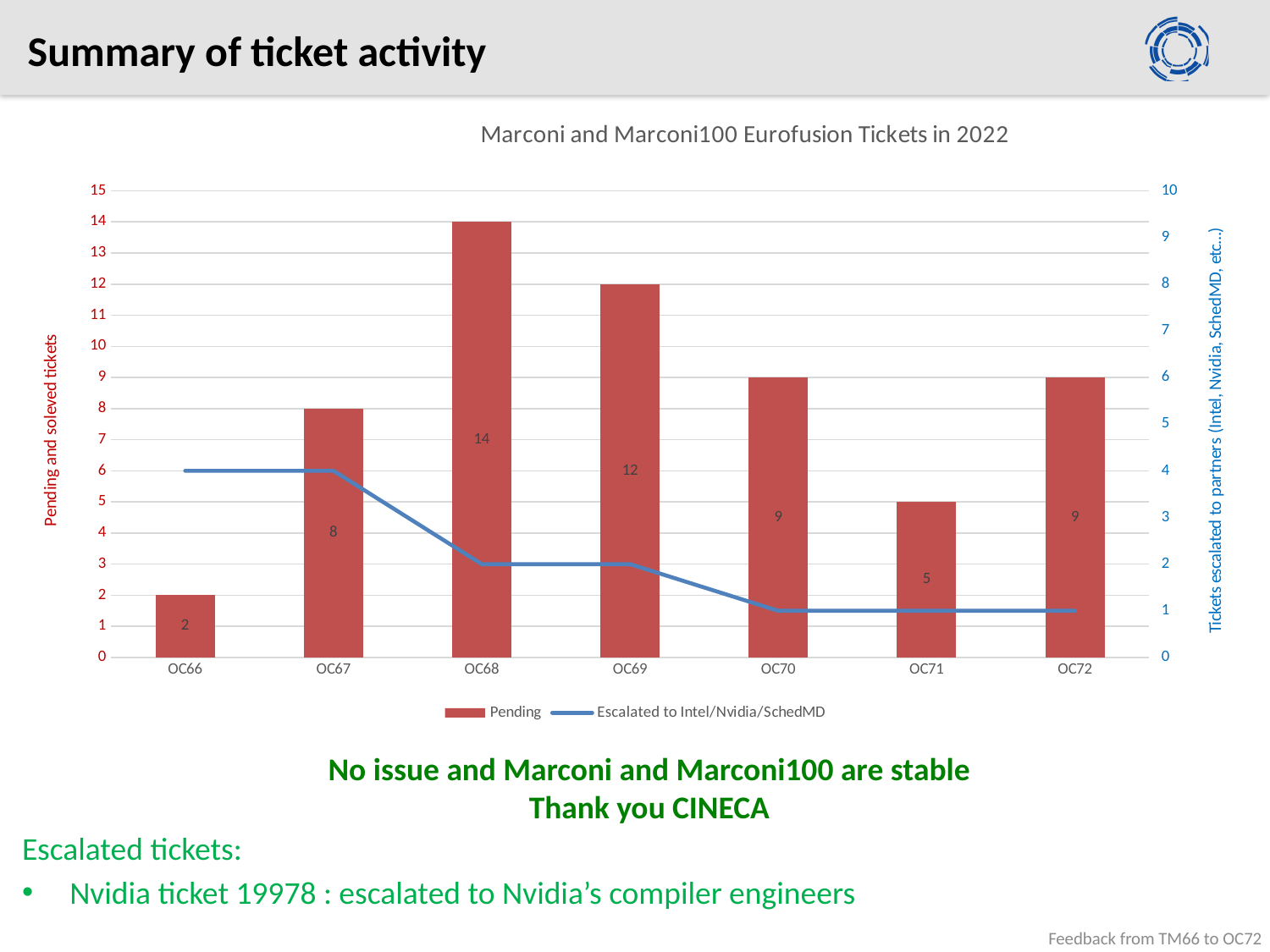
What is the value of the Escalated to Intel/Nvidia/SchedMD line at OC66, read on the right-hand axis? 4 Does the Escalated to Intel/Nvidia/SchedMD line rise or fall from OC66 to OC72? fall How many categories are shown on the x axis? 7 What is the Pending value for OC66? 2 What is the difference between the Pending values for OC68 and OC69? 2 How many series does the legend list? 2 What is the title of the chart? Marconi and Marconi100 Eurofusion Tickets in 2022 Which has a larger Pending value, OC67 or OC70? OC70 What is the Pending value for OC71? 5 Which category has the highest Pending value? OC68 What is the Pending value for OC68? 14 Which category has the lowest Pending value? OC66